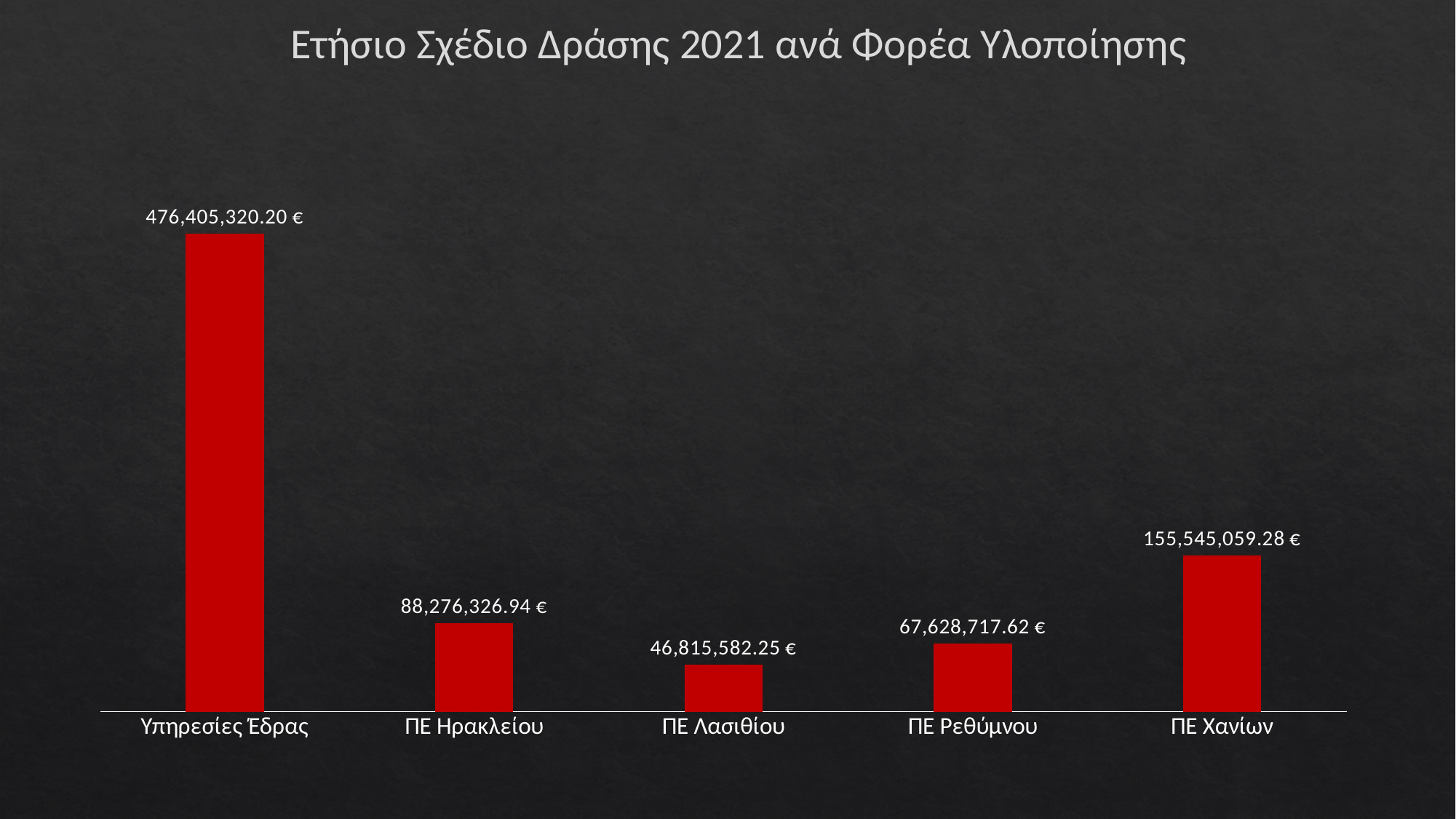
What is the value for ΠΕ Λασιθίου? 46,815,582.25 € What is the value for Υπηρεσίες Έδρας? 476,405,320.20 € What is the value for ΠΕ Ηρακλείου? 88,276,326.94 € Which is larger, the value for ΠΕ Ηρακλείου or the value for ΠΕ Ρεθύμνου? ΠΕ Ηρακλείου Which category has the highest value? Υπηρεσίες Έδρας What is the difference between the values for ΠΕ Χανίων and ΠΕ Ηρακλείου? 67,268,732.34 € How many categories are shown in the chart? 5 What kind of chart is shown on the slide? Bar chart What is the value for ΠΕ Χανίων? 155,545,059.28 € What is the difference between the values for ΠΕ Ρεθύμνου and ΠΕ Λασιθίου? 20,813,135.37 € Which category has the lowest value? ΠΕ Λασιθίου What is the value for ΠΕ Ρεθύμνου? 67,628,717.62 €